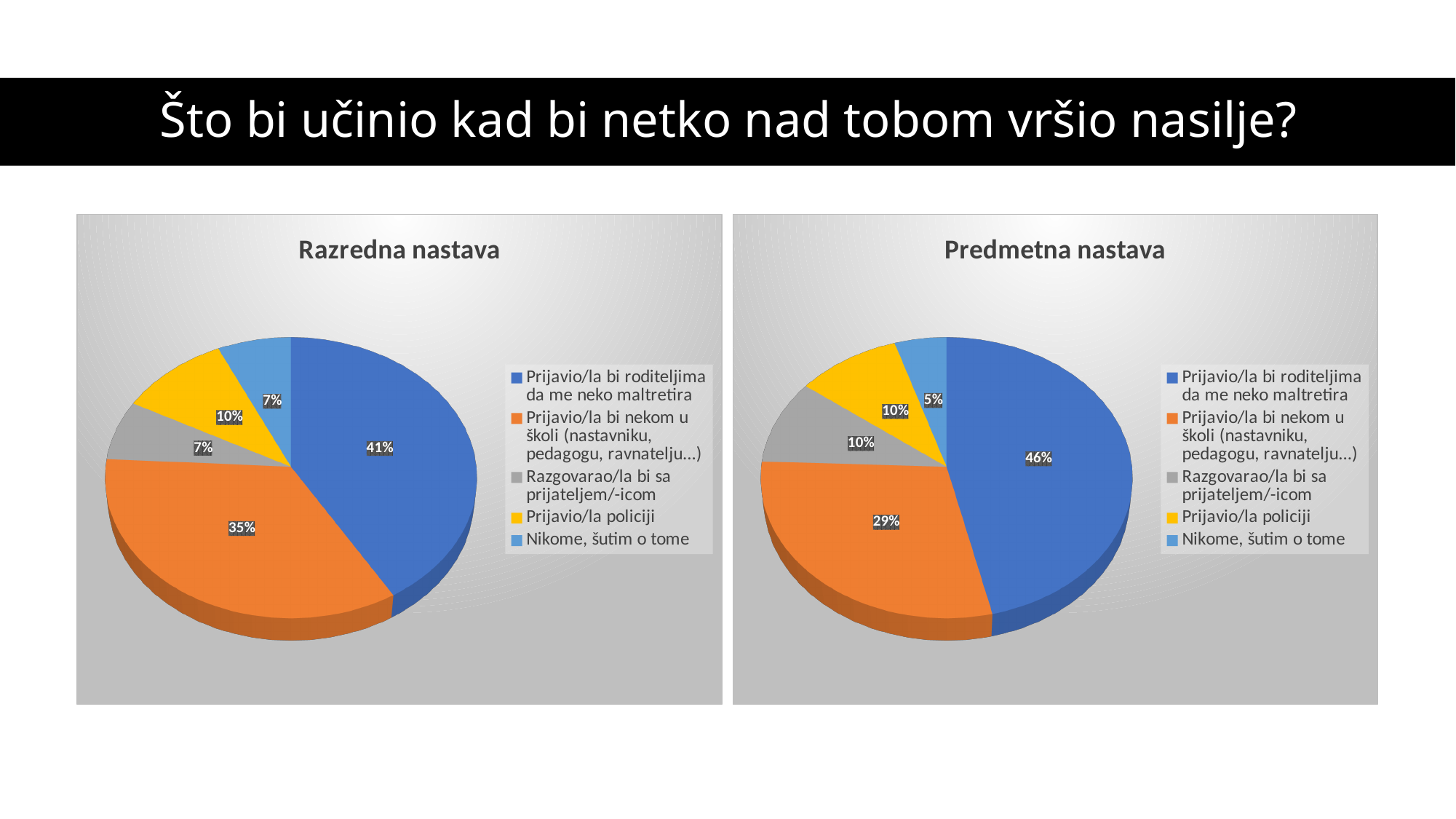
In the 'Predmetna nastava' chart, what colour is the slice for 'Prijavio/la bi nekom u školi (nastavniku, pedagogu, ravnatelju...)'? Orange In the 'Predmetna nastava' chart, which category has the smallest slice? Nikome, šutim o tome In the 'Razredna nastava' chart, what share is labelled for 'Nikome, šutim o tome'? 7% In the 'Predmetna nastava' chart, what share is labelled for 'Prijavio/la bi nekom u školi (nastavniku, pedagogu, ravnatelju...)'? 29% What type of chart is the 'Predmetna nastava' chart? Pie chart In the 'Predmetna nastava' chart, what share is labelled for 'Prijavio/la policiji'? 10% In the 'Razredna nastava' chart, which is larger: the share for 'Prijavio/la policiji' or the share for 'Razgovarao/la bi sa prijateljem/-icom'? Prijavio/la policiji What is the difference between the 'Prijavio/la bi roditeljima da me neko maltretira' share in the 'Predmetna nastava' chart and in the 'Razredna nastava' chart? 5% In the 'Razredna nastava' chart, what share is labelled for 'Prijavio/la bi roditeljima da me neko maltretira'? 41% In the 'Predmetna nastava' chart, which category has the largest slice? Prijavio/la bi roditeljima da me neko maltretira How many slices does the 'Razredna nastava' pie chart have? 5 In the 'Razredna nastava' chart, which category has the largest slice? Prijavio/la bi roditeljima da me neko maltretira